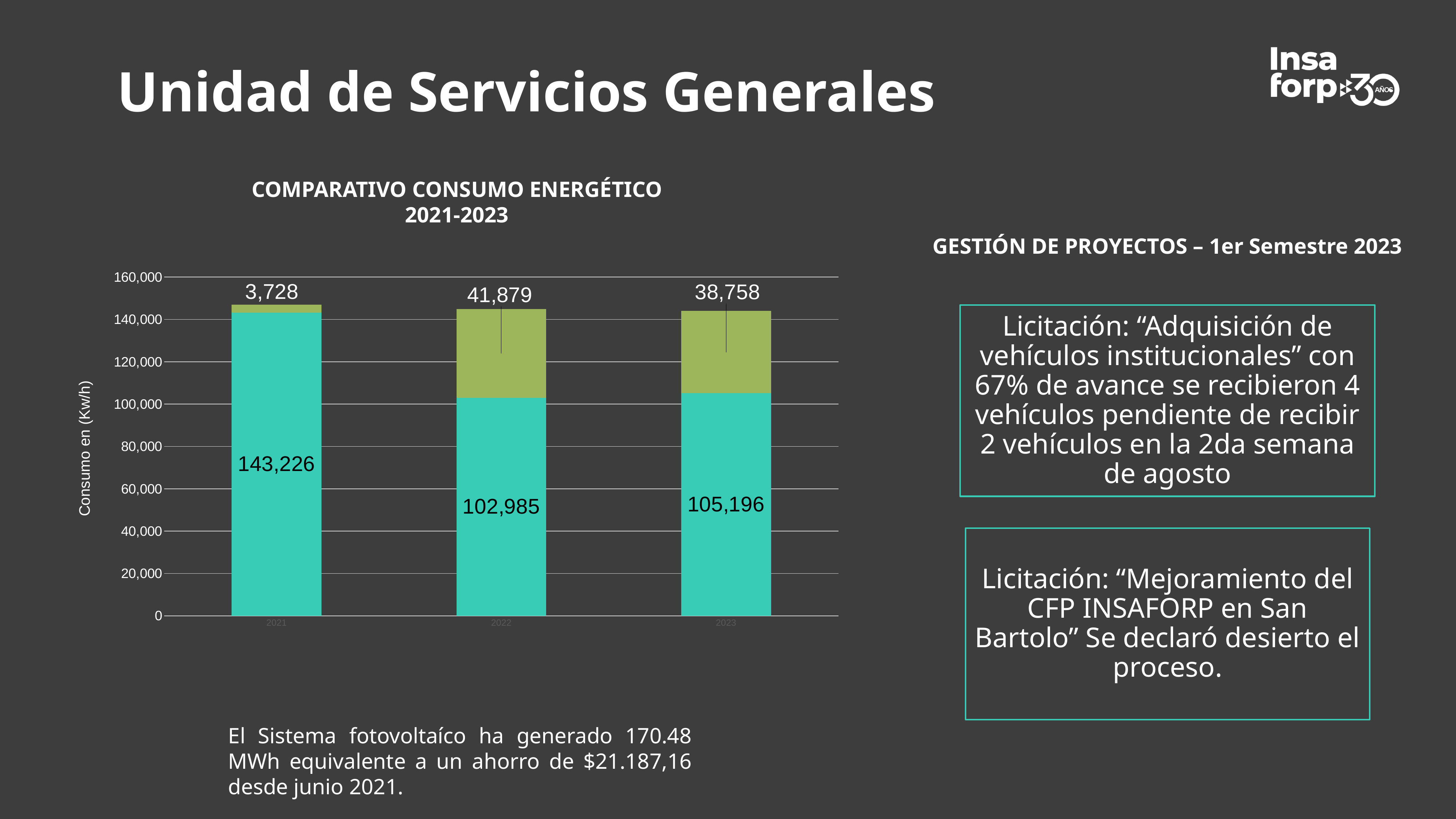
What is the difference between the teal segment values for 2021 and 2022? 40,241 What is the value of the teal (lower) segment for 2021? 143,226 What is the value of the teal (lower) segment for 2022? 102,985 Which year has the highest value for the teal (lower) segment? 2021 What is the value of the olive-green (upper) segment for 2021? 3,728 What kind of chart is shown under the title "COMPARATIVO CONSUMO ENERGÉTICO 2021-2023"? Stacked bar chart Is the olive-green segment larger in 2022 or in 2023? 2022 What label is shown on the vertical axis of the chart? Consumo en (Kw/h) What is the value of the olive-green (upper) segment for 2023? 38,758 How many years (categories) are plotted on the x axis of the chart? 3 Which year has the lowest value for the olive-green (upper) segment? 2021 What is the total of the stacked bar for 2022? 144,864